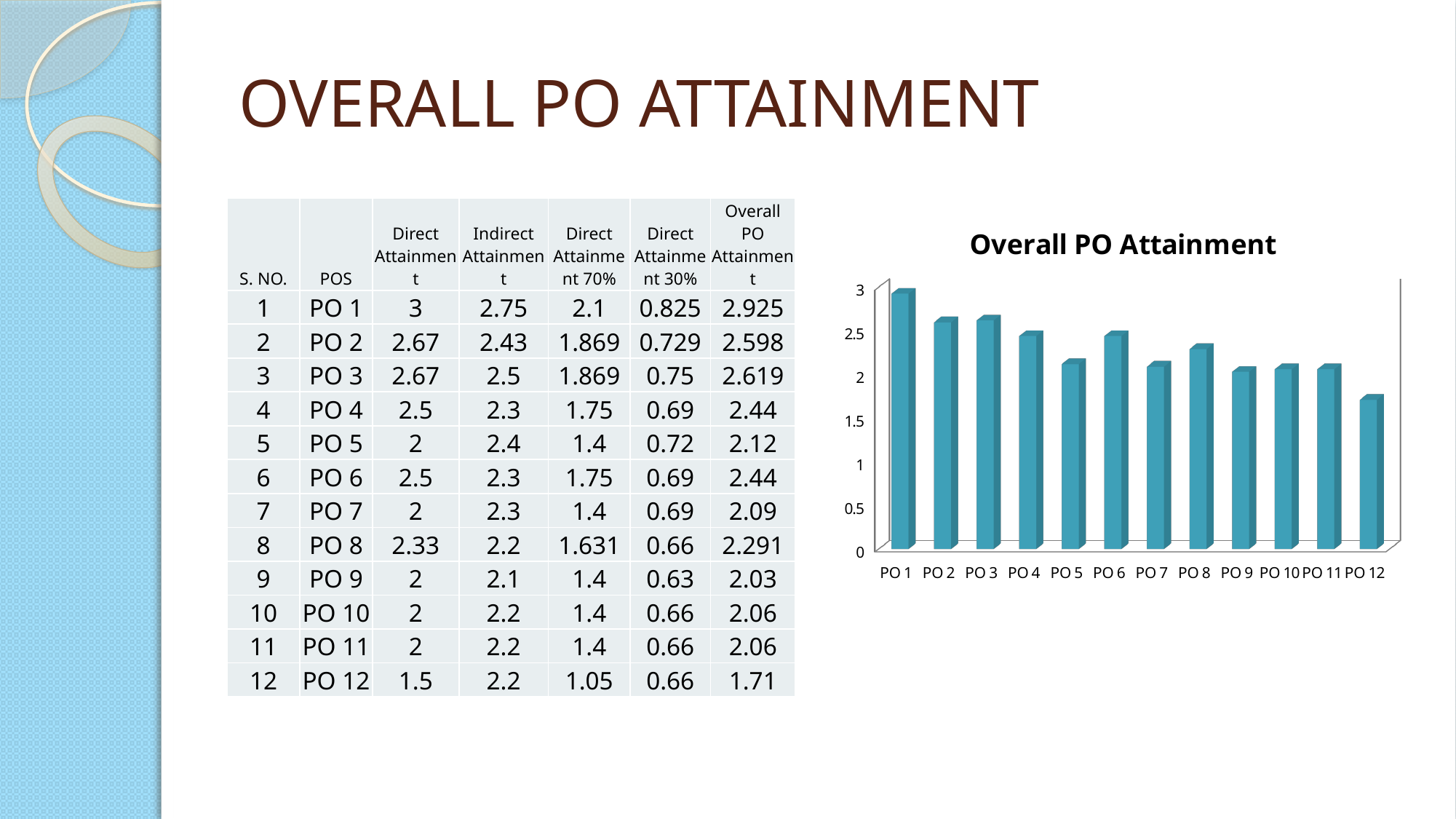
According to the slide, what is the overall PO attainment value for PO 12? 1.71 Which is larger, the value for PO 4 or the value for PO 5? PO 4 Which PO has the highest overall attainment in the chart? PO 1 Do the values generally rise or fall from PO 1 to PO 12 along the x axis? fall What is the title of the chart? Overall PO Attainment According to the slide, what is the overall PO attainment value for PO 1? 2.925 Is the value for PO 1 greater or less than 2.5? greater Is the value for PO 8 greater or less than 2.5? less Is the value for PO 12 greater or less than 2? less Which PO has the lowest overall attainment in the chart? PO 12 How many categories (POs) are plotted in the chart? 12 What kind of chart is shown on the slide? bar chart